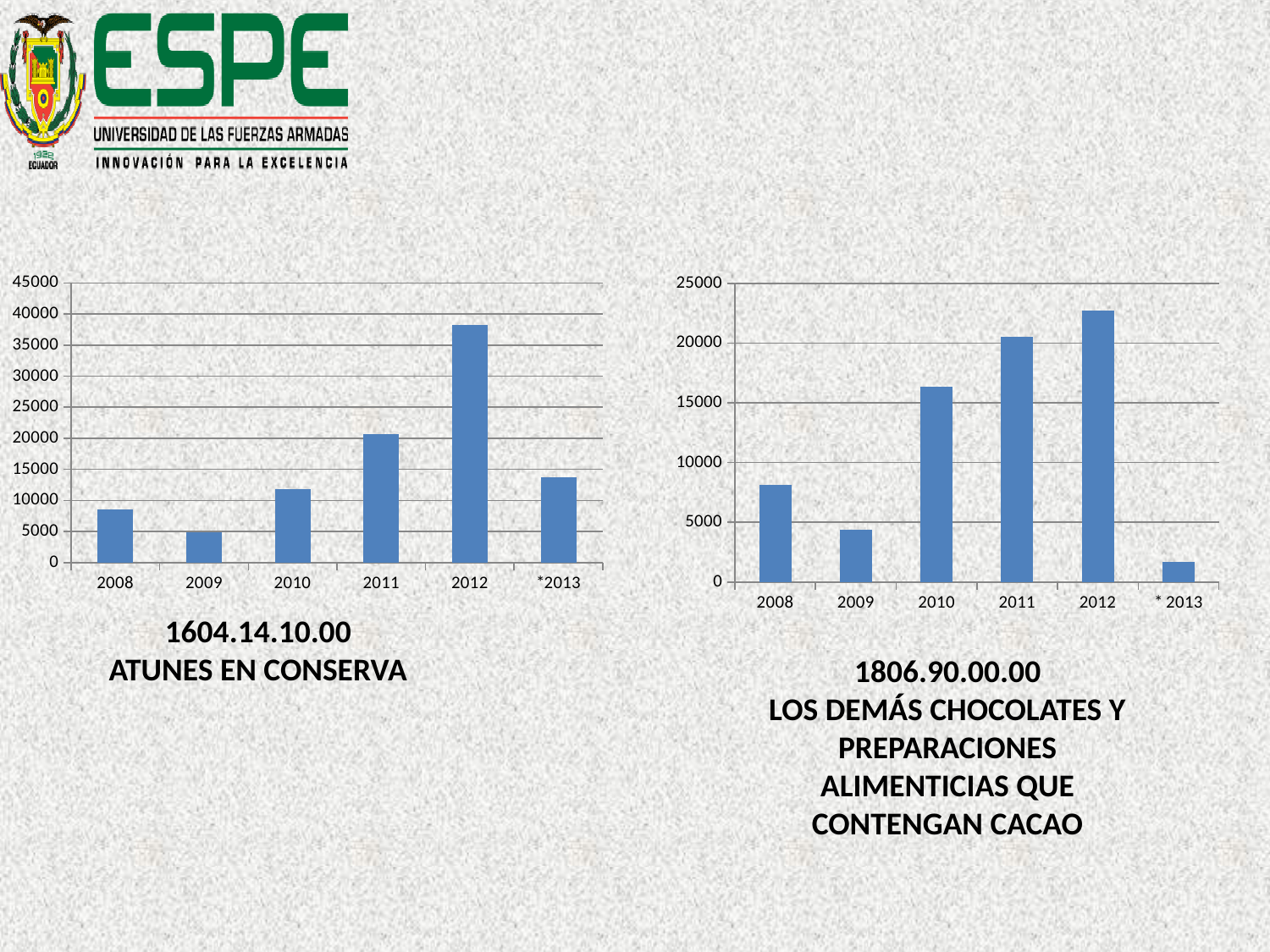
In the ATUNES EN CONSERVA chart, which is larger, the value for 2011 or the value for *2013? 2011 In the ATUNES EN CONSERVA chart, is the value for 2010 greater or less than 15000? less In the ATUNES EN CONSERVA chart, is the value for 2012 greater or less than 35000? greater What is the tariff code shown under the left chart? 1604.14.10.00 How many years are shown on the x axis of the ATUNES EN CONSERVA chart? 6 In the LOS DEMÁS CHOCOLATES chart, which is larger, the value for 2008 or the value for 2009? 2008 In the LOS DEMÁS CHOCOLATES chart, which year has the lowest value? * 2013 In the ATUNES EN CONSERVA chart, which year has the lowest value? 2009 In the ATUNES EN CONSERVA chart, which year has the highest value? 2012 In the LOS DEMÁS CHOCOLATES chart, which year has the highest value? 2012 What kind of chart is the LOS DEMÁS CHOCOLATES chart? Bar chart